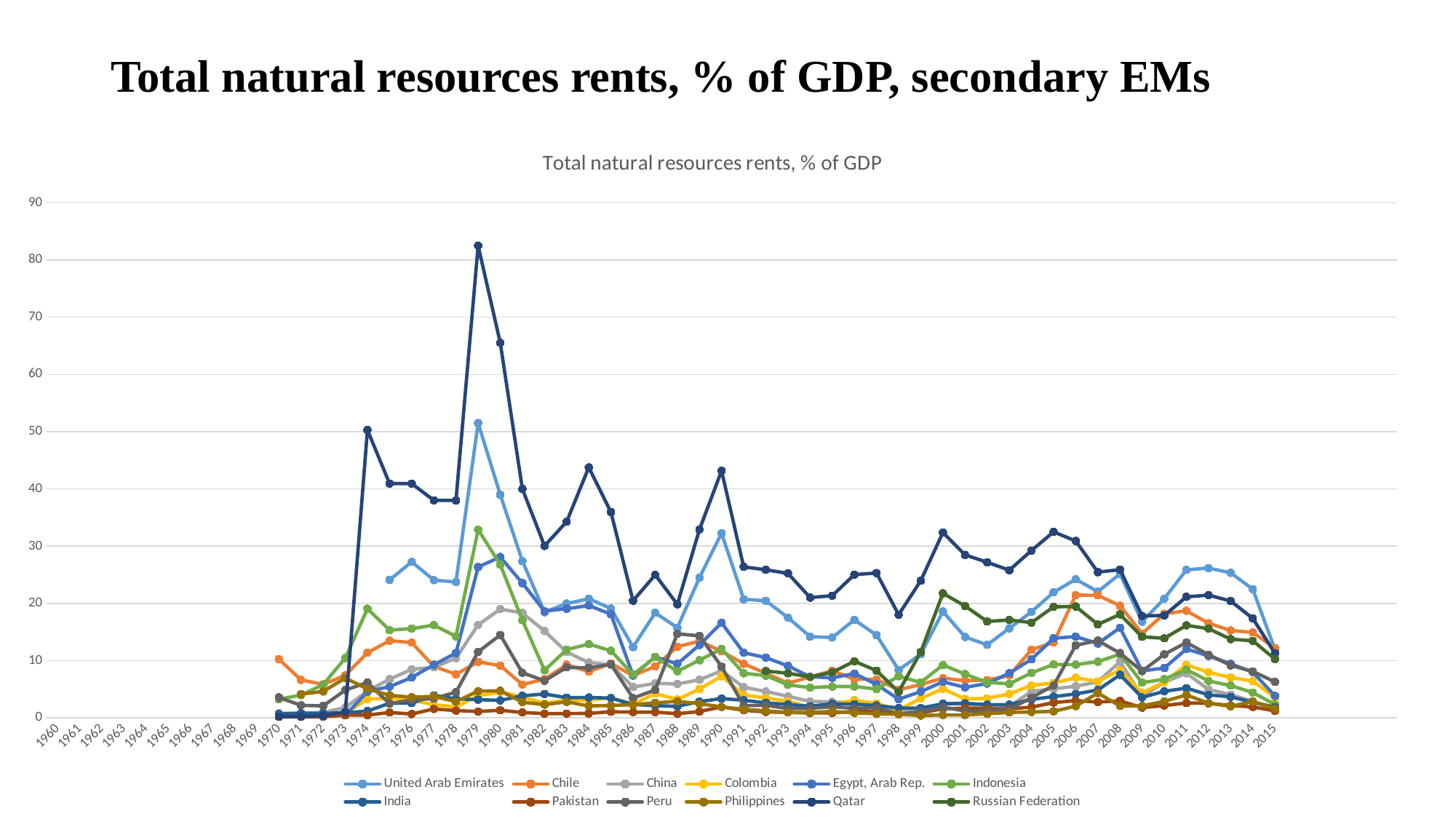
Does the Qatar series rise or fall from 1979 to 1982? fall How many year labels are shown on the x axis? 56 How many series does the legend list? 12 Is the value for Indonesia in 1979 greater or less than 30? greater Is the value for Qatar in 1990 greater or less than 40? greater Is the value for Qatar in 1979 greater or less than 80? greater In which year does the Qatar series reach its peak? 1979 Which series reaches the highest value anywhere on the chart? Qatar What is the title shown above the chart's plot area? Total natural resources rents, % of GDP Which is larger in 1979, the value for Qatar or the value for United Arab Emirates? Qatar What kind of chart is shown on the slide? line chart